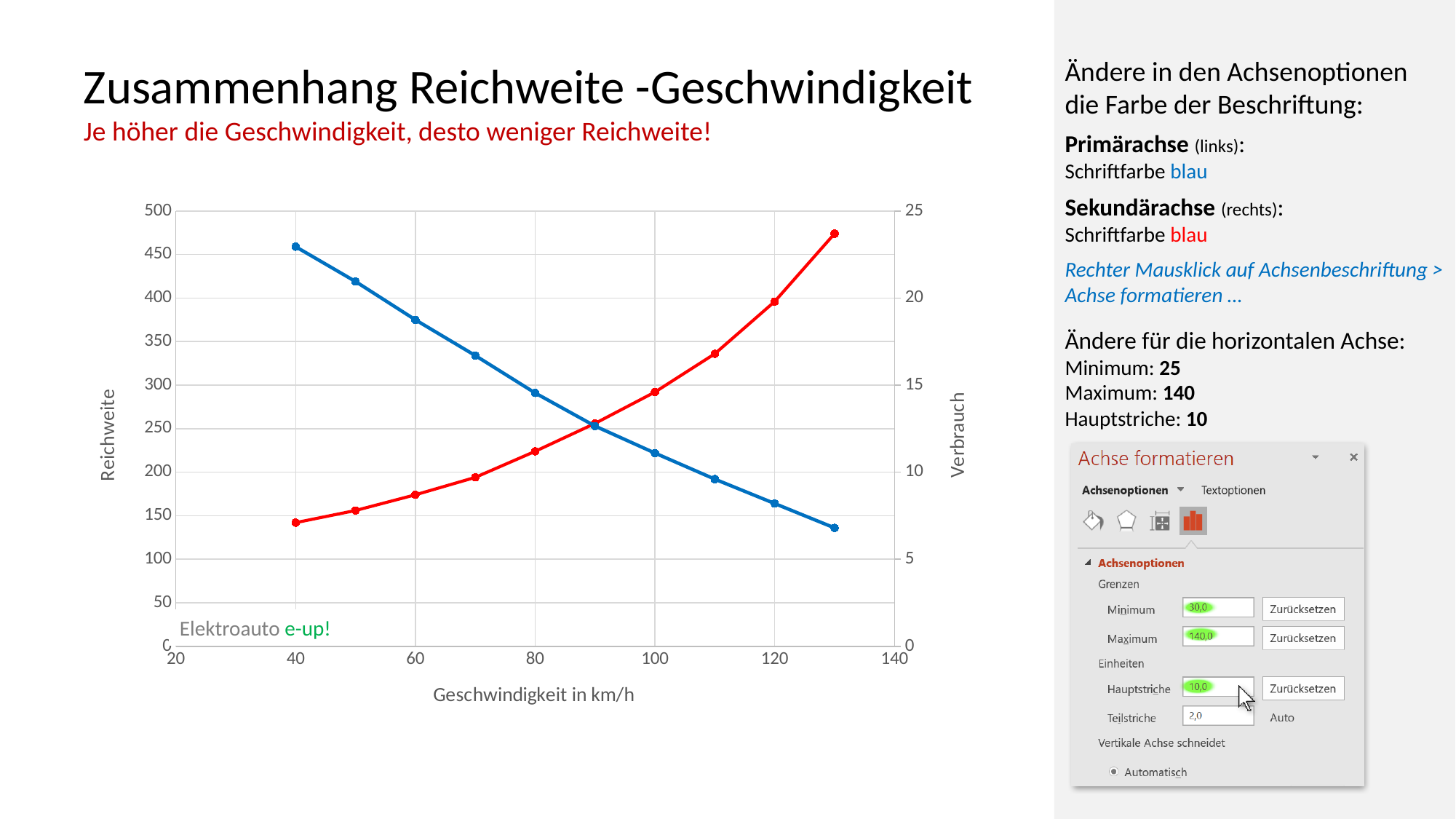
Is the Reichweite at 60 km/h greater or less than 350? greater What is the title of the horizontal axis of the chart? Geschwindigkeit in km/h Does the Verbrauch (red) line rise or fall as Geschwindigkeit increases? rise Is the Verbrauch at 130 km/h greater or less than 20 on the right axis? greater At which Geschwindigkeit is the Reichweite (blue line) lowest? 130 What is the title of the right-hand vertical axis of the chart? Verbrauch What kind of chart is shown on the slide? line chart At which Geschwindigkeit is the Reichweite (blue line) highest? 40 How many data points does the blue Reichweite line have? 10 Is the Reichweite at 130 km/h greater or less than 150? less Does the Reichweite (blue) line rise or fall as Geschwindigkeit increases? fall At which Geschwindigkeit is the Verbrauch (red line) highest? 130